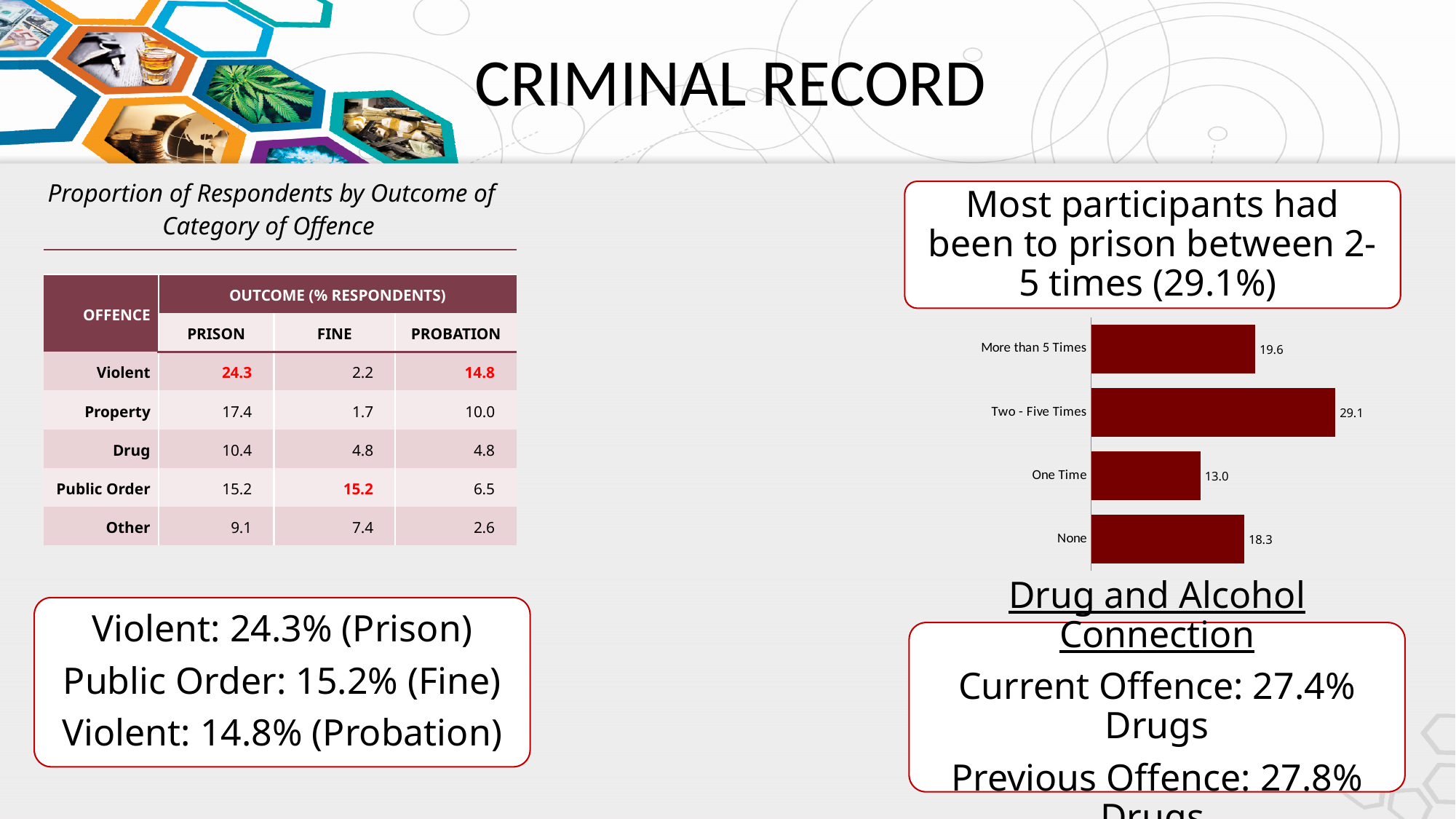
Which category has the highest value in the bar chart? Two - Five Times What kind of chart is shown on the right of the slide? Bar chart How many categories are shown in the bar chart? 4 What is the value for None in the bar chart? 18.3 In the bar chart, which is larger: the value for More than 5 Times or the value for None? More than 5 Times What is the value for Two - Five Times in the bar chart? 29.1 What is the difference between the values for Two - Five Times and One Time in the bar chart? 16.1 Which category has the lowest value in the bar chart? One Time What is the difference between the values for More than 5 Times and None in the bar chart? 1.3 What is the value for One Time in the bar chart? 13.0 What is the value for More than 5 Times in the bar chart? 19.6 What colour are the bars in the bar chart? Dark red